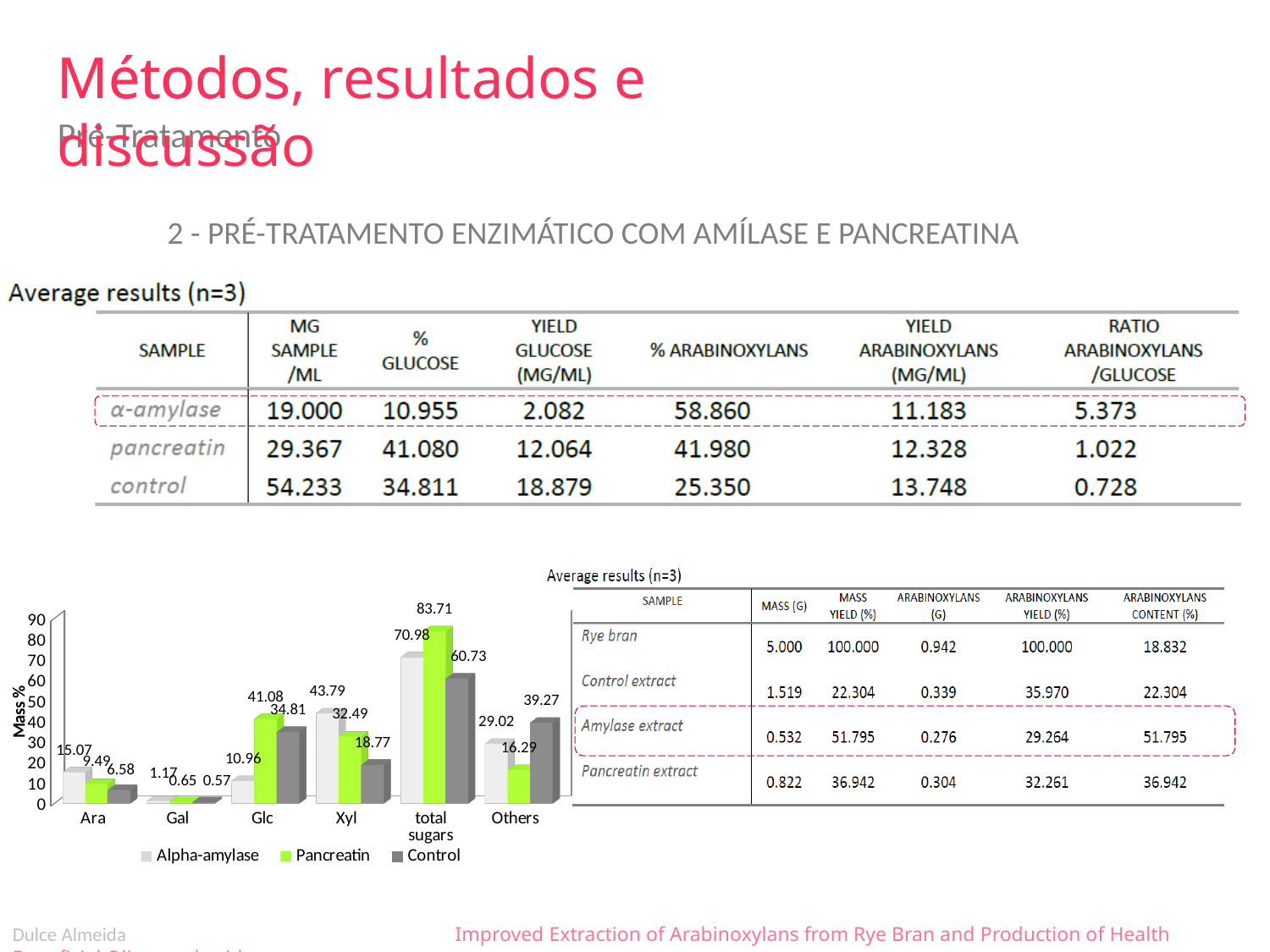
Which category has the highest Control value? total sugars How many series does the chart legend list? 3 What is the label of the y axis of the chart? Mass % What is the Control value for Others? 39.27 What is the difference between the Pancreatin and Alpha-amylase values for Glc? 30.12 Is the Alpha-amylase value for total sugars greater or less than 60? greater Which category has the lowest Pancreatin value? Gal What kind of chart is shown on the slide? bar chart How many categories are shown on the x axis of the chart? 6 What is the Alpha-amylase value for Xyl? 43.79 What is the Pancreatin value for total sugars? 83.71 For Ara, which series has the larger value, Alpha-amylase or Control? Alpha-amylase